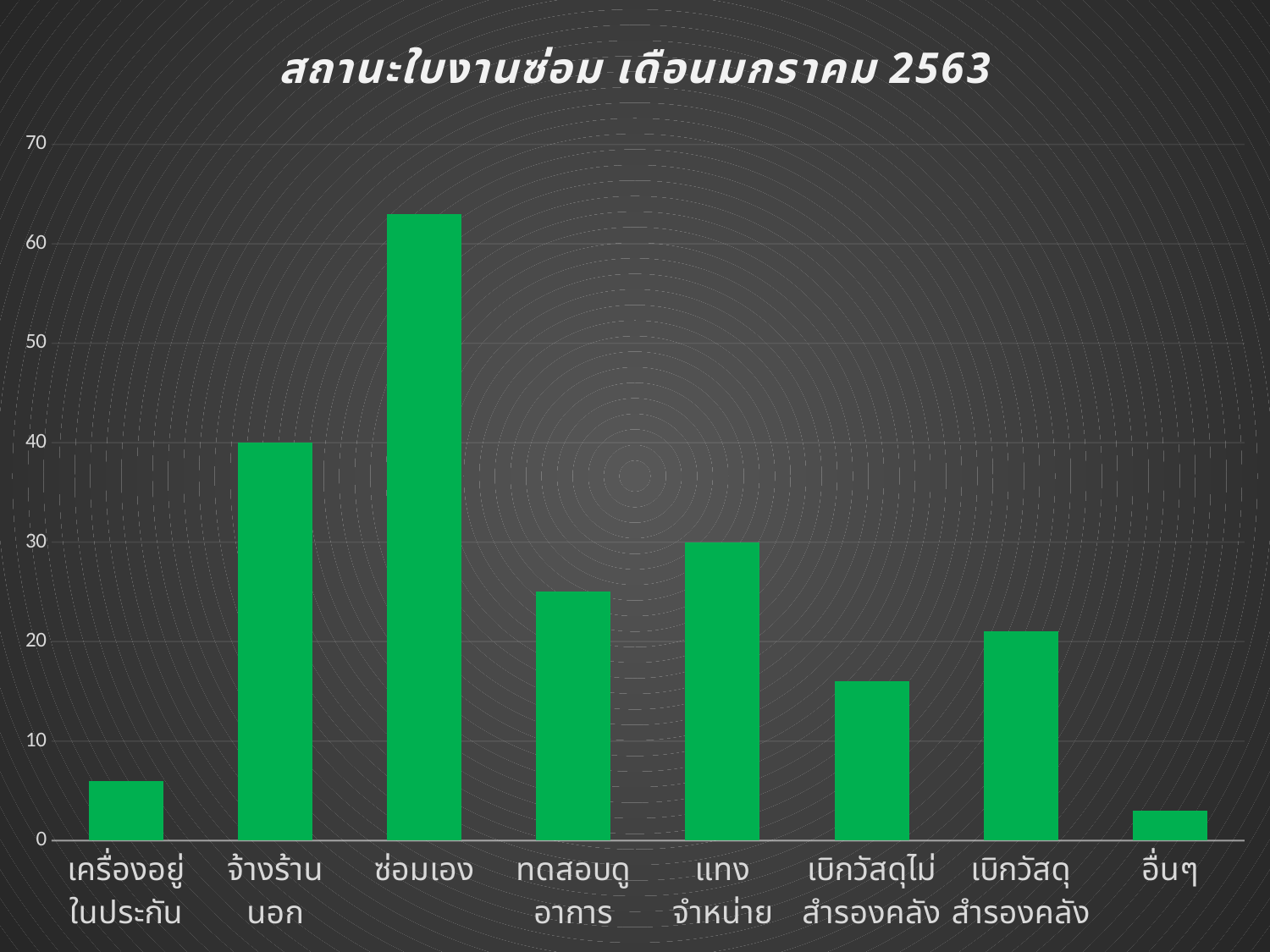
Is the value for เครื่องอยู่ในประกัน greater or less than 10? less Which category has the lowest value? อื่นๆ What is the difference between the values for จ้างร้านนอก and แทงจำหน่าย? 10 What is the title of the chart? สถานะใบงานซ่อม เดือนมกราคม 2563 What is the value for จ้างร้านนอก? 40 How many categories are shown on the x axis? 8 Which is larger, the value for ทดสอบดูอาการ or the value for เบิกวัสดุไม่สำรองคลัง? ทดสอบดูอาการ What is the value for แทงจำหน่าย? 30 Is the value for ซ่อมเอง greater or less than 60? greater What type of chart is shown on the slide? bar chart Which category has the highest value? ซ่อมเอง